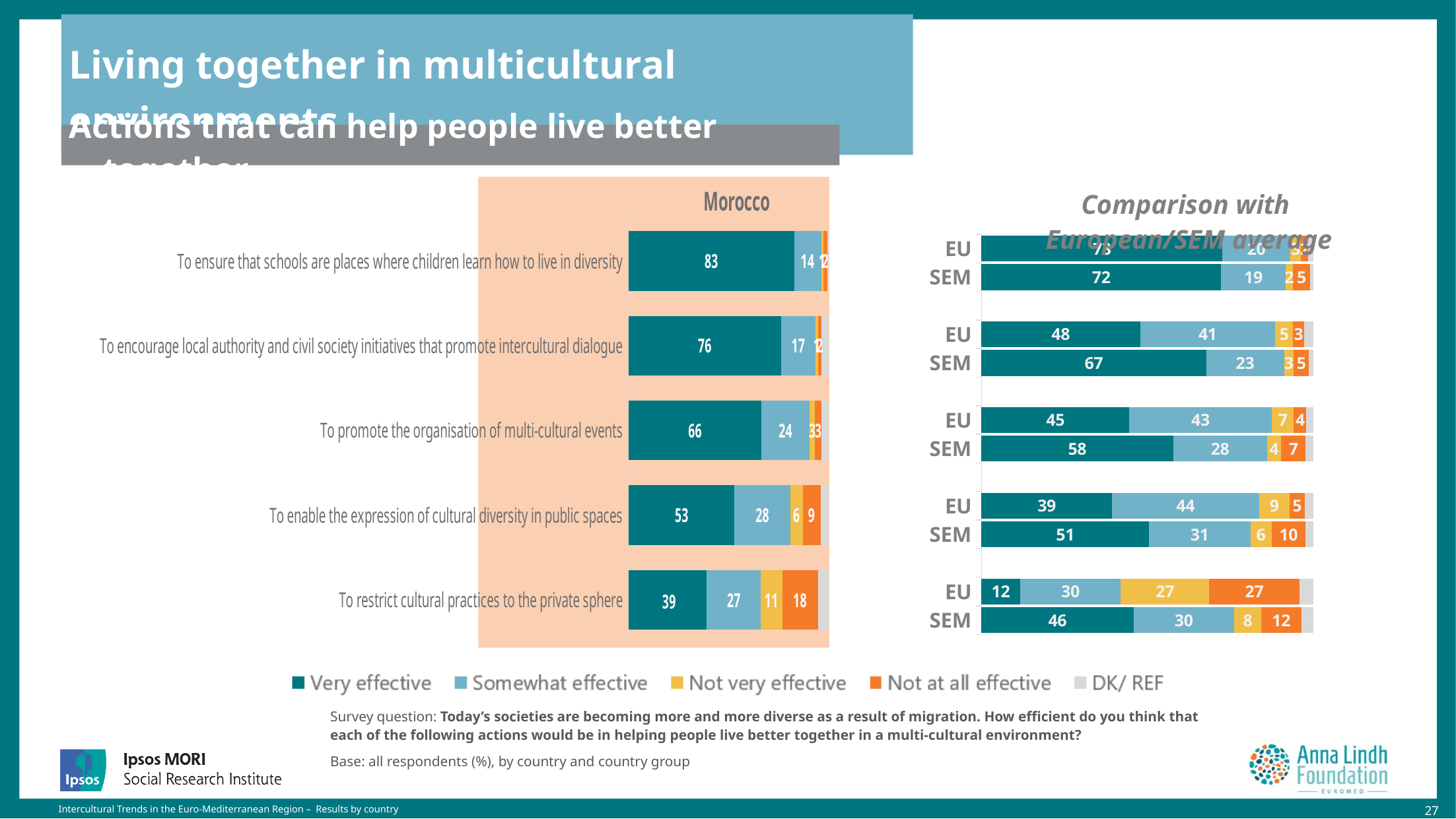
How many series does the legend list? 5 In the Comparison with European/SEM average chart, what is the EU 'Not at all effective' value for restricting cultural practices to the private sphere? 27 What kind of chart is the Morocco chart? Bar chart In the Morocco chart, which action has the lowest 'Very effective' value? To restrict cultural practices to the private sphere In the Morocco chart, what is the 'Not at all effective' value for 'To restrict cultural practices to the private sphere'? 18 In the Comparison with European/SEM average chart, what is the EU 'Very effective' value for encouraging local authority and civil society initiatives? 48 In the Morocco chart, what is the difference between the 'Very effective' values for the schools action and the restrict cultural practices action? 44 In the Comparison with European/SEM average chart, for promoting the organisation of multi-cultural events, which has the larger 'Very effective' value, EU or SEM? SEM In the Morocco chart, what percentage rated 'To ensure that schools are places where children learn how to live in diversity' as very effective? 83 In the Morocco chart, what is the 'Somewhat effective' value for 'To enable the expression of cultural diversity in public spaces'? 28 In the Morocco chart, which action has the highest 'Very effective' value? To ensure that schools are places where children learn how to live in diversity In the Comparison with European/SEM average chart, what is the SEM 'Very effective' value for restricting cultural practices to the private sphere? 46